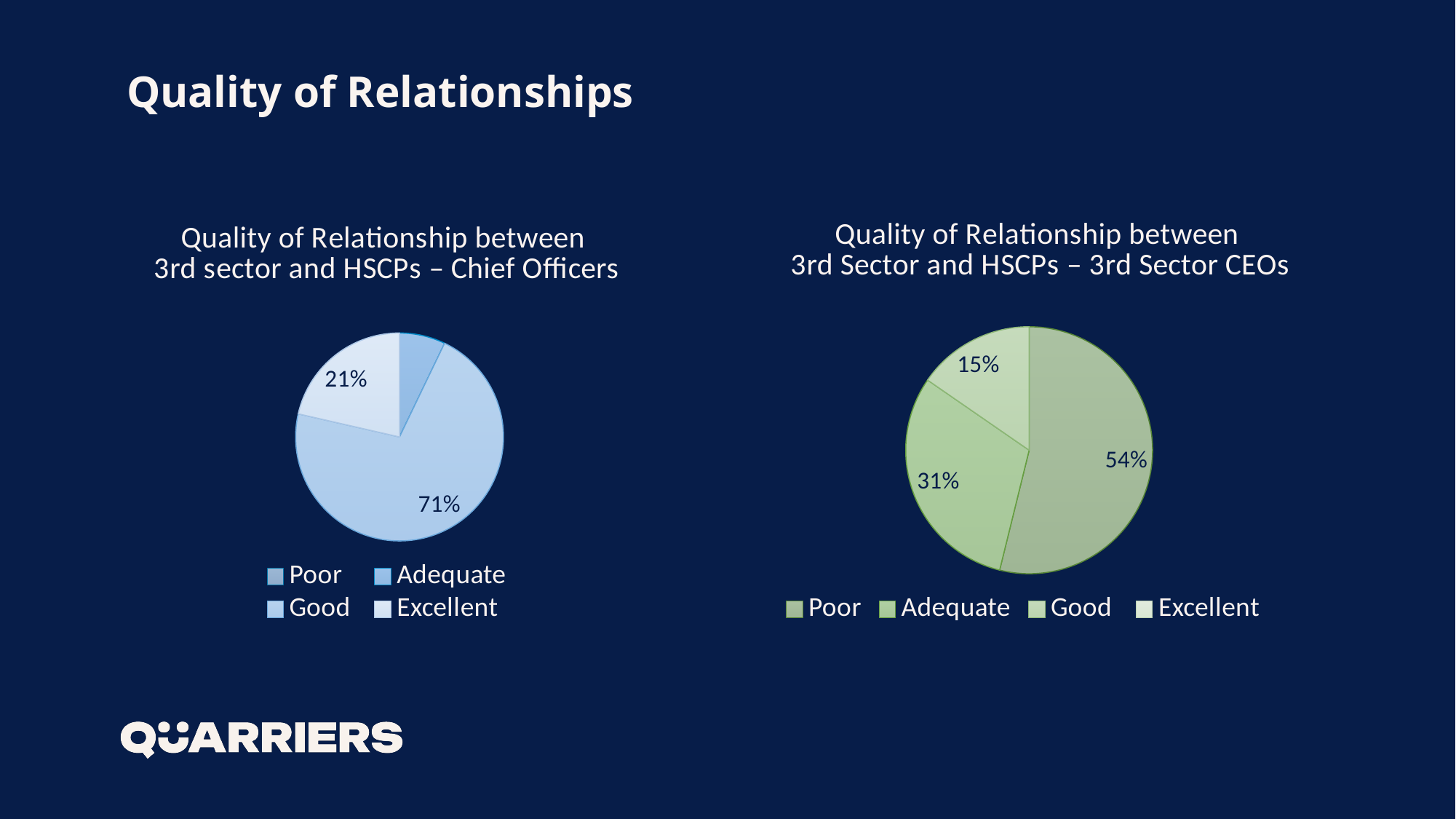
In the right pie chart (3rd Sector CEOs), what is the percentage of the smallest labelled slice? 15% In the right pie chart (3rd Sector CEOs), what is the percentage of the largest slice? 54% In the right pie chart (3rd Sector CEOs), what is the difference between the 54% slice and the 31% slice? 23% What is the title of the right pie chart on the slide? Quality of Relationship between 3rd Sector and HSCPs – 3rd Sector CEOs In the left pie chart (Chief Officers), what percentage is shown for the largest slice? 71% Which is larger: the largest slice of the left pie chart (Chief Officers) or the largest slice of the right pie chart (3rd Sector CEOs)? The left chart's largest slice (71%) In the left pie chart (Chief Officers), which category does the 71% slice represent? Good In the left pie chart (Chief Officers), what is the difference between the 71% slice and the 21% slice? 50% In the right pie chart (3rd Sector CEOs), how many slices have a percentage label? 3 How many categories does the legend of the left pie chart (Chief Officers) list? 4 In the left pie chart (Chief Officers), what percentage is shown for the Excellent slice? 21% What type of chart is used on the left of the slide, titled 'Quality of Relationship between 3rd sector and HSCPs – Chief Officers'? Pie chart